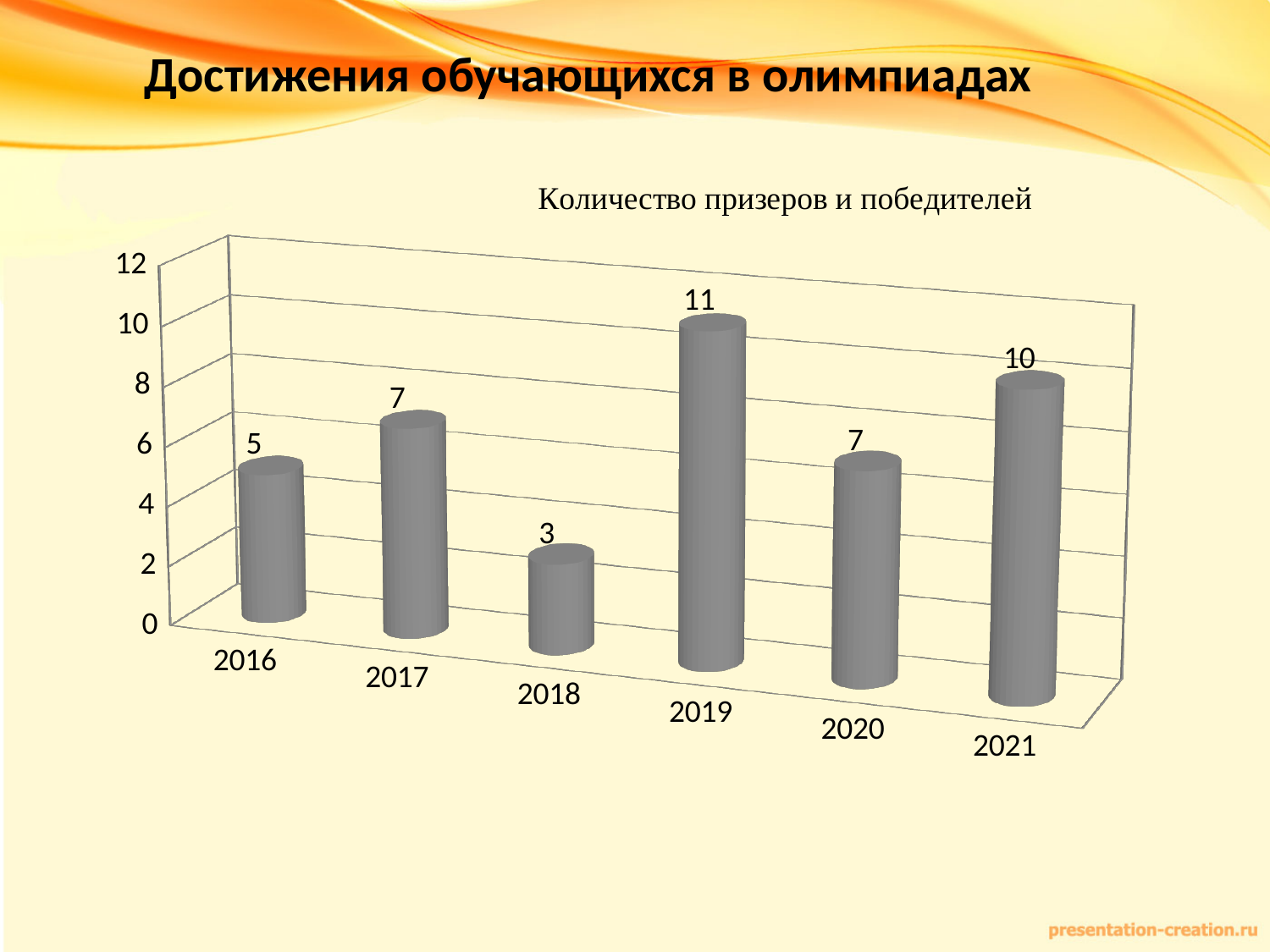
Which is larger, the value for 2017 or the value for 2016? 2017 What is the difference between the values for 2021 and 2020? 3 What is the title of the chart? Количество призеров и победителей What is the difference between the values for 2019 and 2018? 8 What is the value for 2019? 11 What is the value for 2021? 10 Which year has the highest value? 2019 Is the value for 2019 greater or less than 10? greater How many years are shown on the chart? 6 What is the value for 2016? 5 What kind of chart is shown on the slide? bar chart Which year has the lowest value? 2018